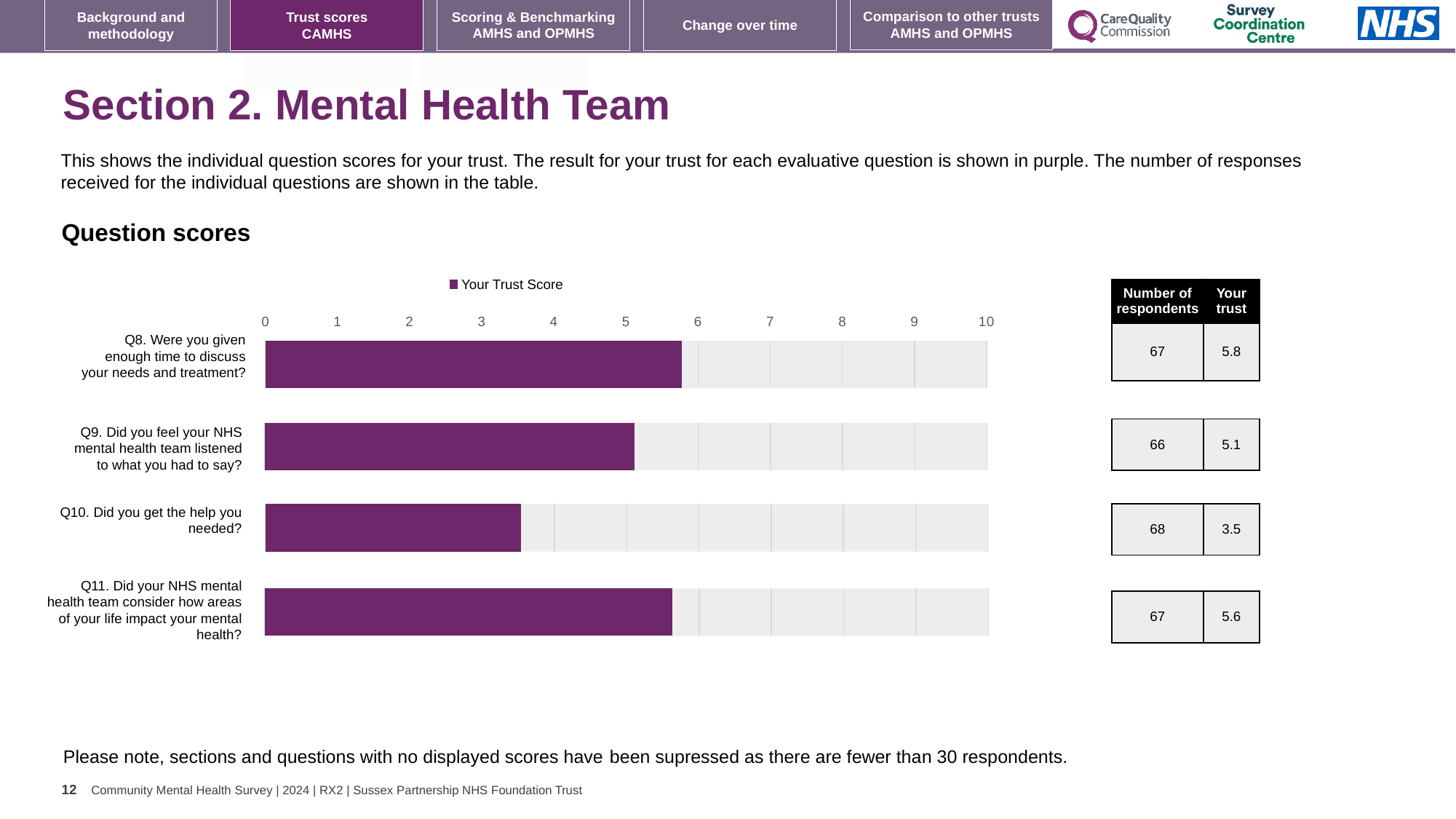
What kind of chart is the Question scores chart? Bar chart What is the Your Trust Score for Q11 (Did your NHS mental health team consider how areas of your life impact your mental health?)? 5.6 Which question has the lowest Your Trust Score? Q10 Which has a higher Your Trust Score, Q9 or Q11? Q11 What is the Your Trust Score for Q8 (Were you given enough time to discuss your needs and treatment?)? 5.8 What is the Your Trust Score for Q10 (Did you get the help you needed?)? 3.5 Which question has the highest Your Trust Score? Q8 What is the difference between the Your Trust Score for Q8 and Q10? 2.3 What is the name of the series shown in the legend of the Question scores chart? Your Trust Score How many questions are plotted in the Question scores chart? 4 How many series does the legend of the Question scores chart list? 1 Is the Your Trust Score for Q9 greater or less than 4? greater